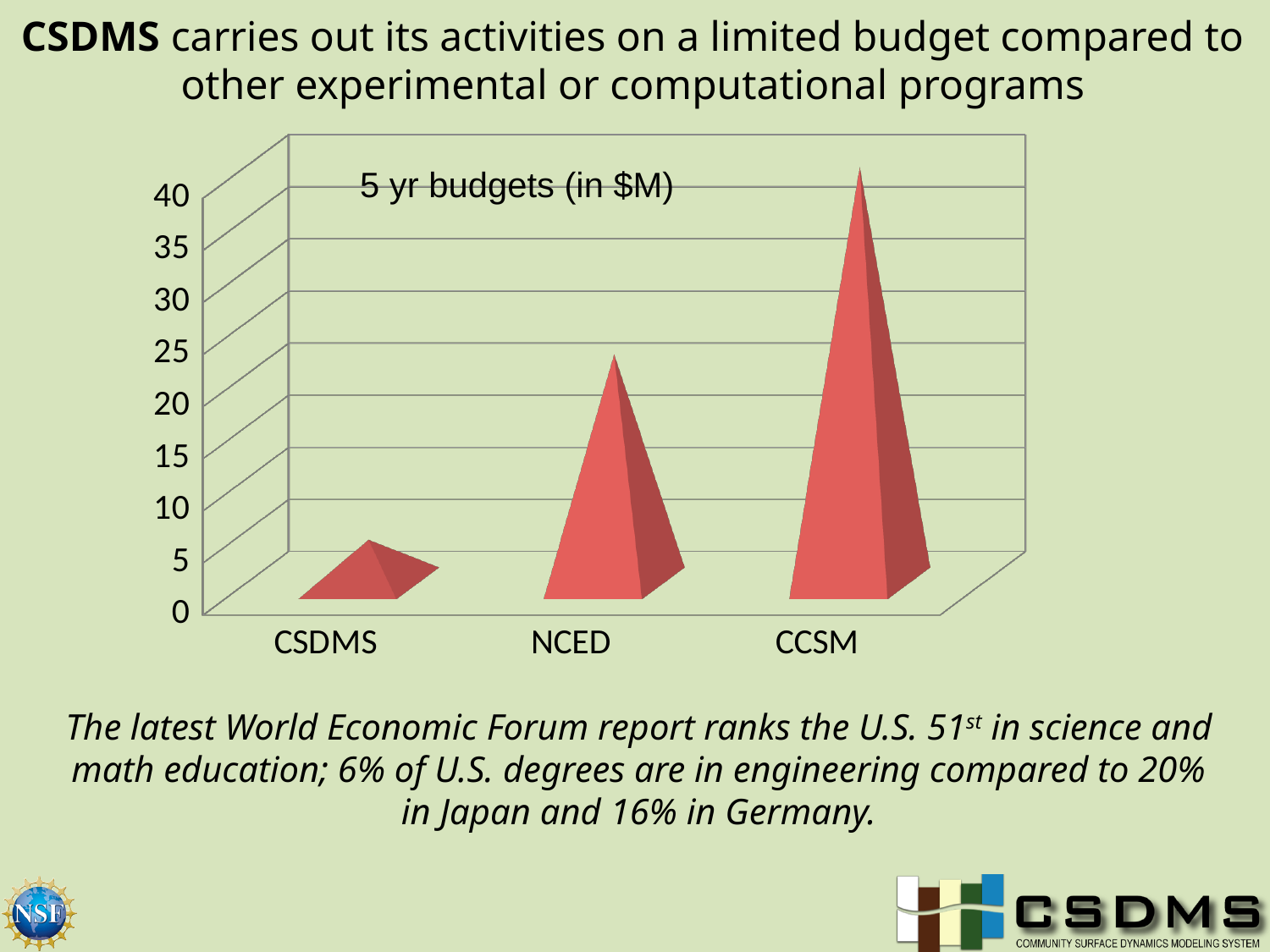
Is the value for CSDMS greater or less than 10? less What kind of chart is shown on the slide? bar chart Which program has the smallest 5 yr budget in the chart? CSDMS What is the highest value labelled on the vertical axis of the chart? 40 How many programs are shown on the x axis of the chart? 3 What is the title of the chart? 5 yr budgets (in $M) Which program has the largest 5 yr budget in the chart? CCSM Which has a larger 5 yr budget, NCED or CSDMS? NCED Do the values rise or fall moving from CSDMS to CCSM along the x axis? rise Is the value for CCSM greater or less than 35? greater Which has a larger 5 yr budget, CCSM or NCED? CCSM Is the value for NCED greater or less than 20? greater